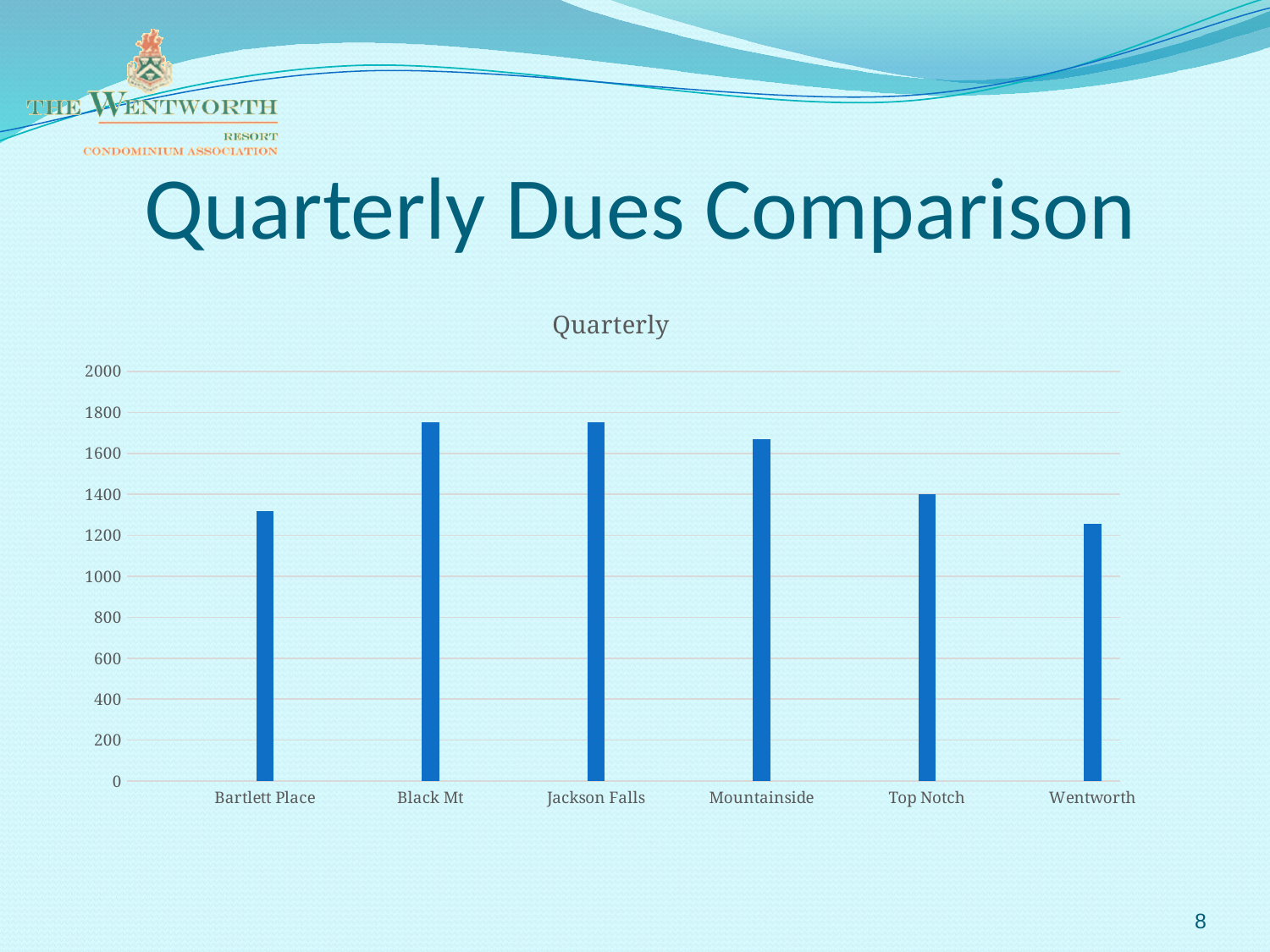
Which has the larger value, Black Mt or Top Notch? Black Mt Which has the larger value, Bartlett Place or Jackson Falls? Jackson Falls Is the value for Jackson Falls greater or less than 1800? less Which has the larger value, Mountainside or Wentworth? Mountainside Is the value for Black Mt greater or less than 1600? greater Is the value for Wentworth greater or less than 1000? greater What is the title of the chart? Quarterly How many categories are shown on the x axis of the chart? 6 What kind of chart is shown on the slide? bar chart